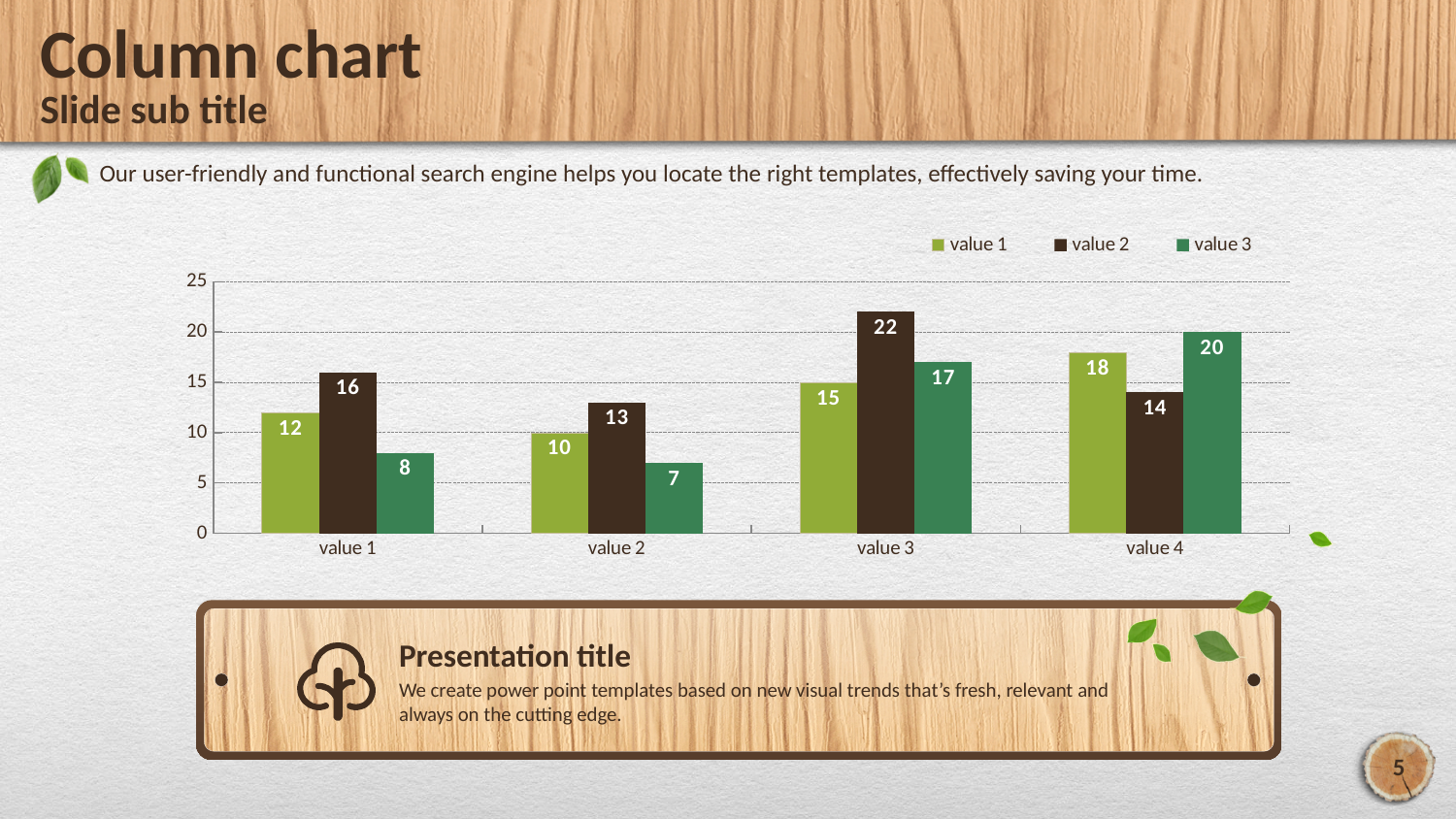
What is the value of series 'value 1' for category 'value 4'? 18 Which category has the highest value for series 'value 1'? value 4 What is the value of series 'value 3' for category 'value 2'? 7 What kind of chart is shown on the slide? bar chart How many categories are shown on the x axis? 4 What is the difference between series 'value 2' and series 'value 3' for category 'value 1'? 8 What is the value of series 'value 2' for category 'value 3'? 22 What is the total of the three series for category 'value 3'? 54 For category 'value 4', which is larger: series 'value 1' or series 'value 2'? value 1 What is the highest value shown on the y axis? 25 Which category has the lowest value for series 'value 3'? value 2 How many series does the legend list? 3